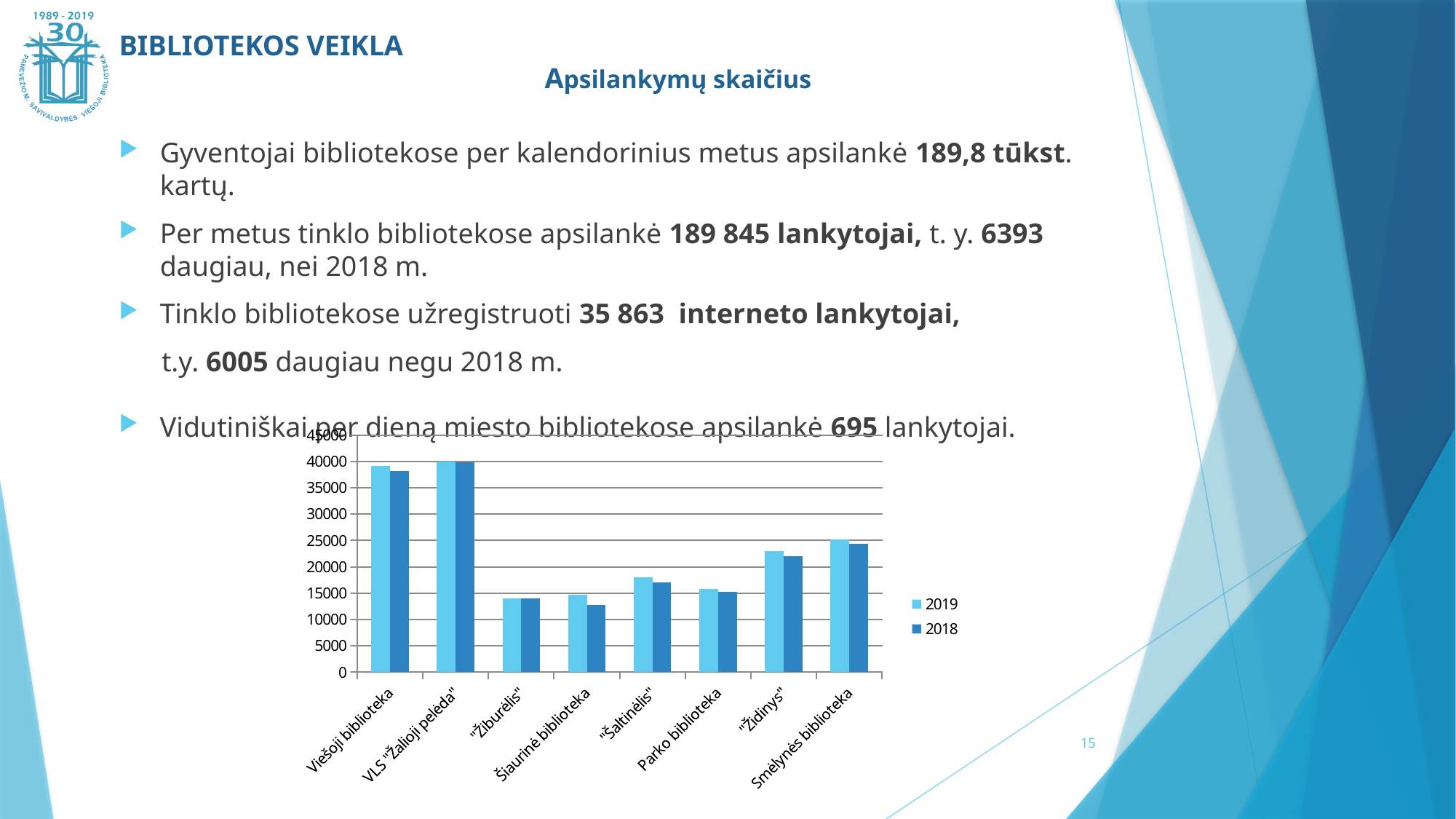
Is the 2019 value for "Žiburėlis" greater or less than 15000? less Is the 2018 value for Šiaurinė biblioteka greater or less than 10000? greater How many libraries (categories) are shown on the x axis of the chart? 8 Which library has the lowest 2018 value in the chart? Šiaurinė biblioteka How many series does the chart legend list? 2 Is the 2019 value for "Šaltinėlis" greater or less than 15000? greater What kind of chart is shown on the slide? bar chart Which years are listed in the chart legend? 2019 and 2018 For "Židinys", which year has the larger value, 2019 or 2018? 2019 For Šiaurinė biblioteka, which year has the larger value, 2019 or 2018? 2019